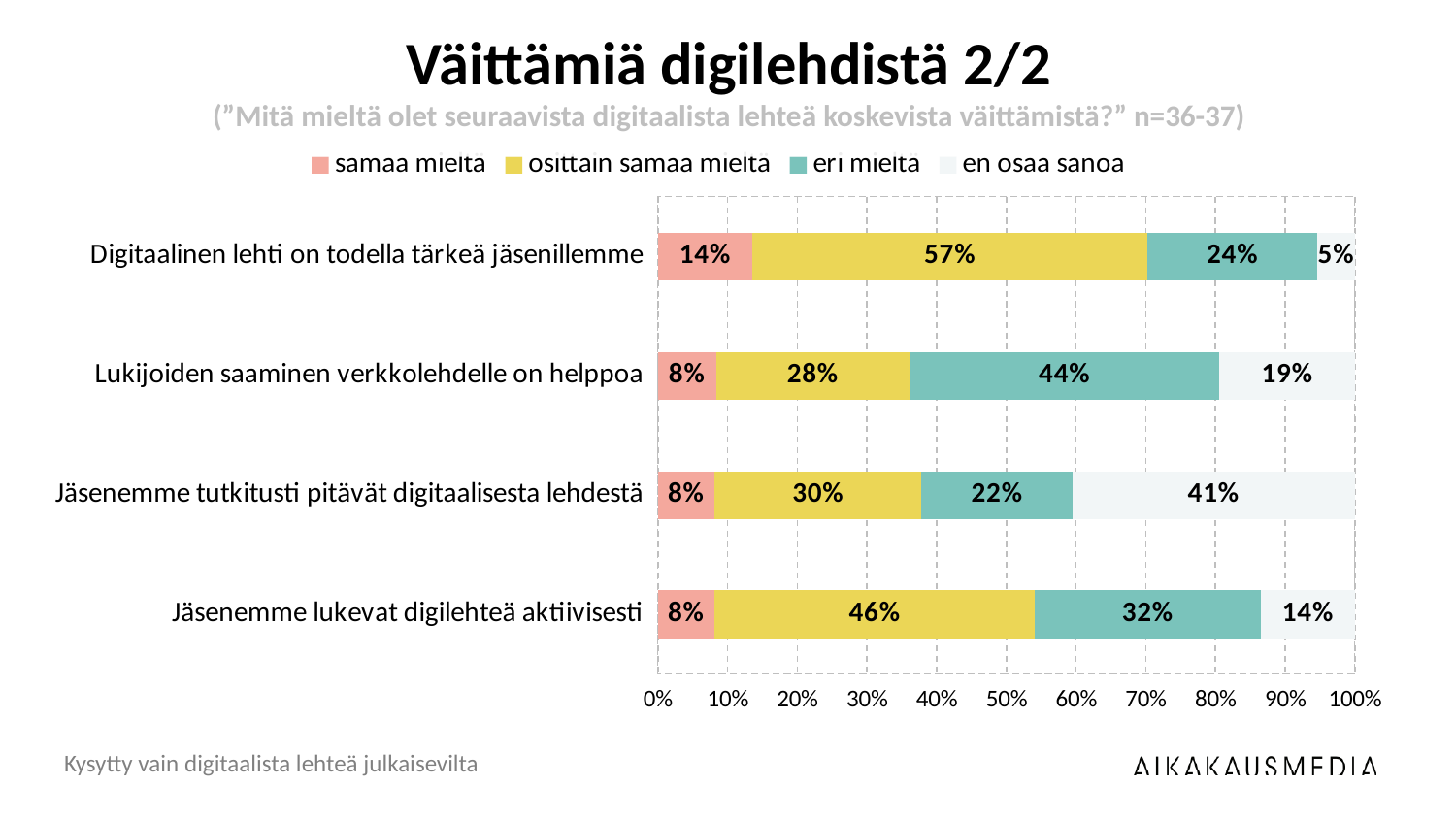
What kind of chart is shown on the slide? Stacked bar chart How many series does the legend list? 4 What is the "eri mieltä" share for "Lukijoiden saaminen verkkolehdelle on helppoa"? 44% How many statements are shown in the chart? 4 What is the "osittain samaa mieltä" share for "Jäsenemme lukevat digilehteä aktiivisesti"? 46% What is the "en osaa sanoa" share for "Jäsenemme tutkitusti pitävät digitaalisesta lehdestä"? 41% What percentage of respondents answered "samaa mieltä" to "Digitaalinen lehti on todella tärkeä jäsenillemme"? 14% Which statement has the highest "osittain samaa mieltä" share? Digitaalinen lehti on todella tärkeä jäsenillemme Which is larger: the "eri mieltä" share for "Jäsenemme lukevat digilehteä aktiivisesti" or for "Digitaalinen lehti on todella tärkeä jäsenillemme"? Jäsenemme lukevat digilehteä aktiivisesti What is the total of the stacked bar for "Digitaalinen lehti on todella tärkeä jäsenillemme"? 100% What is the difference between the "eri mieltä" shares for "Lukijoiden saaminen verkkolehdelle on helppoa" and "Jäsenemme tutkitusti pitävät digitaalisesta lehdestä"? 22% Which statement has the lowest "en osaa sanoa" share? Digitaalinen lehti on todella tärkeä jäsenillemme